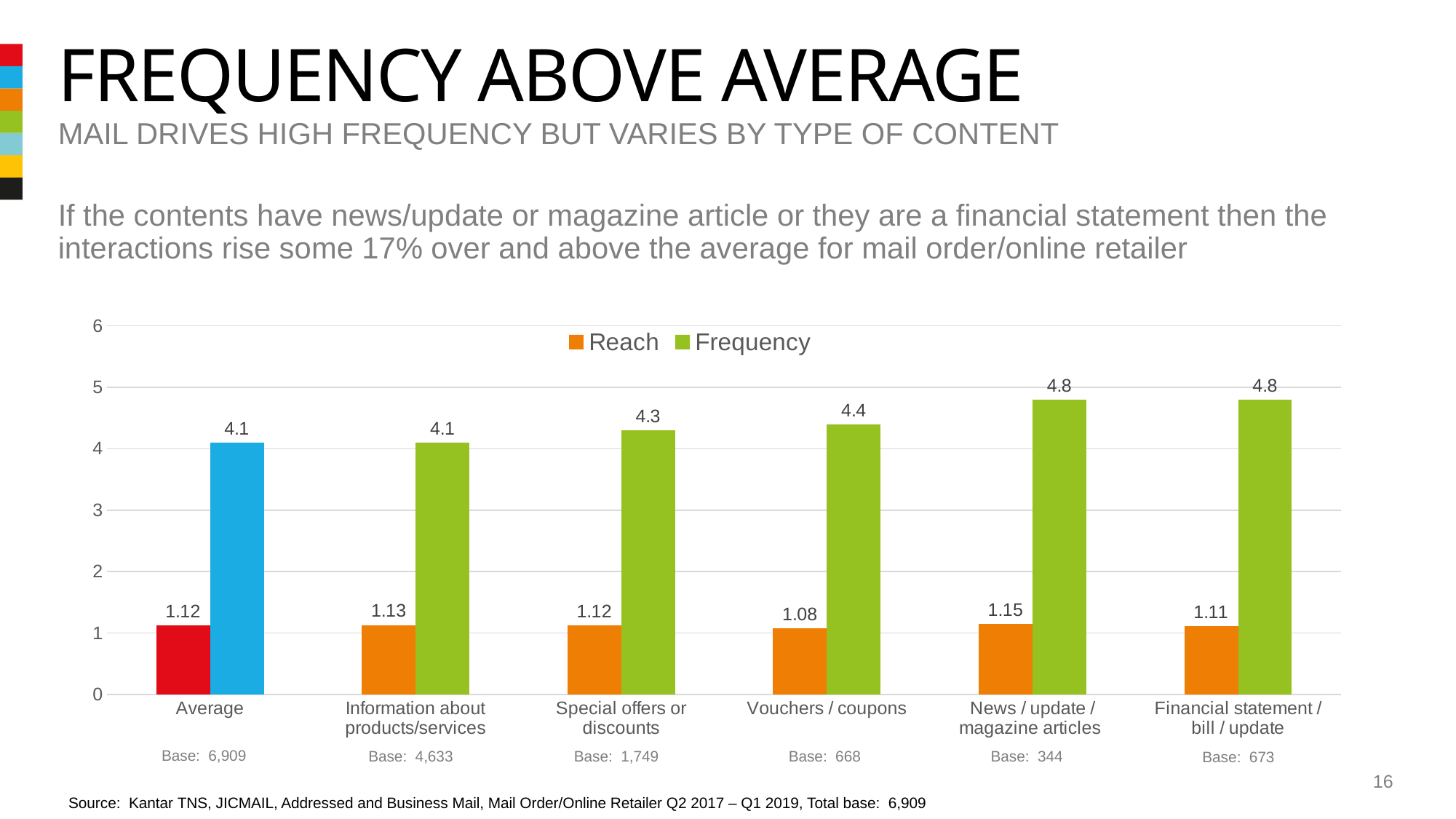
Which category has the lowest Reach value? Vouchers / coupons What is the difference between the Frequency value for Financial statement / bill / update and the Average Frequency value? 0.7 How many series does the legend list? 2 What is the Reach value for the Average category? 1.12 What is the Reach value for News / update / magazine articles? 1.15 Is the Frequency value for News / update / magazine articles greater or less than 4? greater What kind of chart is shown on the slide? Bar chart Which category has the highest Reach value? News / update / magazine articles How many categories are shown on the x axis? 6 What colour are the Frequency bars in the legend? Green What is the Frequency value for Vouchers / coupons? 4.4 Which is larger, the Frequency value for Special offers or discounts or the Frequency value for Information about products/services? Special offers or discounts